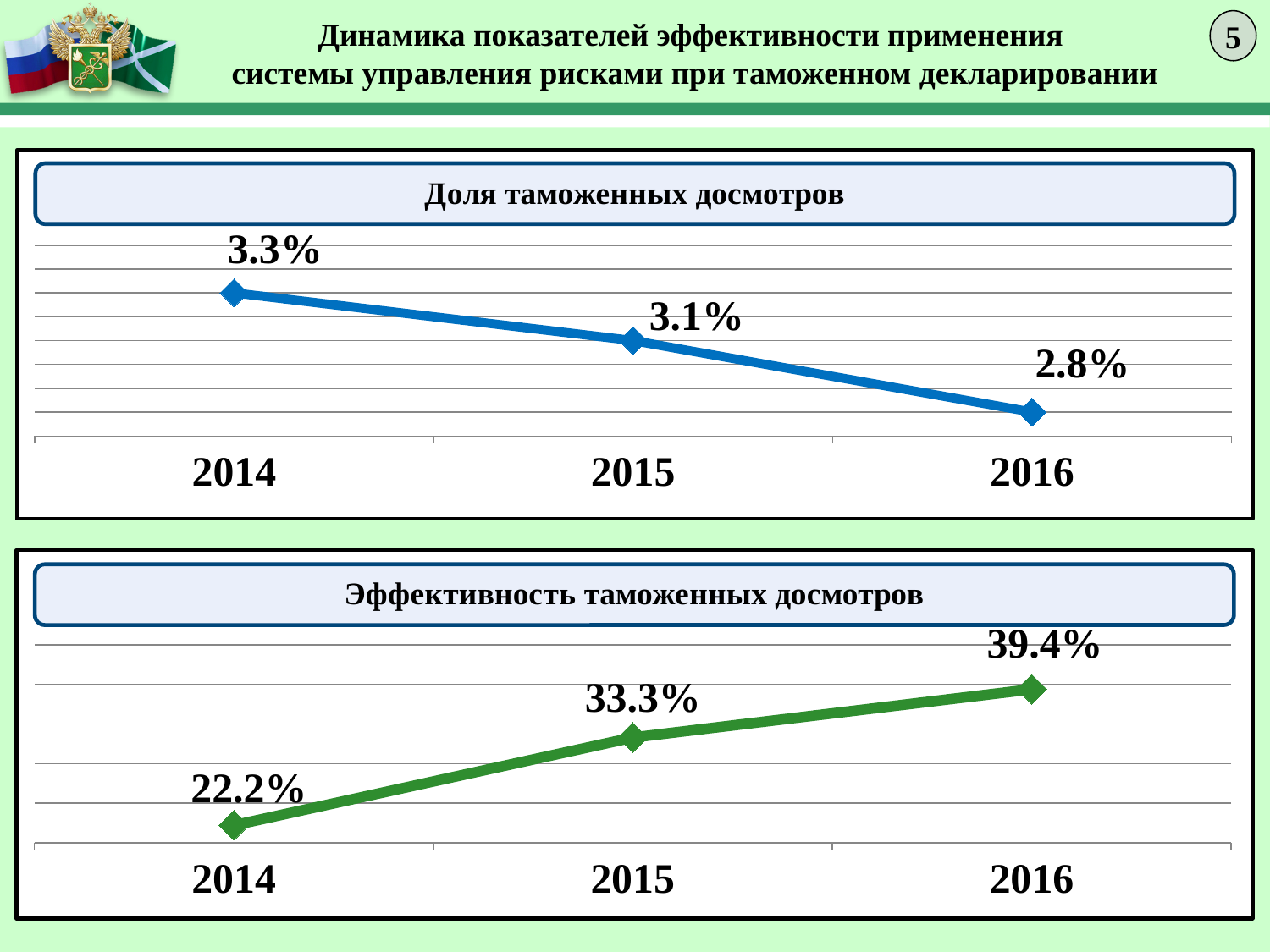
In the chart titled 'Эффективность таможенных досмотров', do the values rise or fall from 2014 to 2016? rise In the chart titled 'Доля таможенных досмотров', what is the difference between the 2014 and 2016 values? 0.5% In the chart titled 'Эффективность таможенных досмотров', what is the difference between the 2016 and 2014 values? 17.2% In the chart titled 'Доля таможенных досмотров', what is the value for 2016? 2.8% In the chart titled 'Доля таможенных досмотров', which year has the lowest value? 2016 In the chart titled 'Эффективность таможенных досмотров', what is the value for 2014? 22.2% In the chart titled 'Доля таможенных досмотров', do the values rise or fall from 2014 to 2016? fall In the chart titled 'Доля таможенных досмотров', what is the value for 2014? 3.3% What kind of chart is the chart titled 'Эффективность таможенных досмотров'? line chart In the chart titled 'Эффективность таможенных досмотров', what is the value for 2015? 33.3% How many data points are plotted in the chart titled 'Доля таможенных досмотров'? 3 In the chart titled 'Эффективность таможенных досмотров', which year has the highest value? 2016